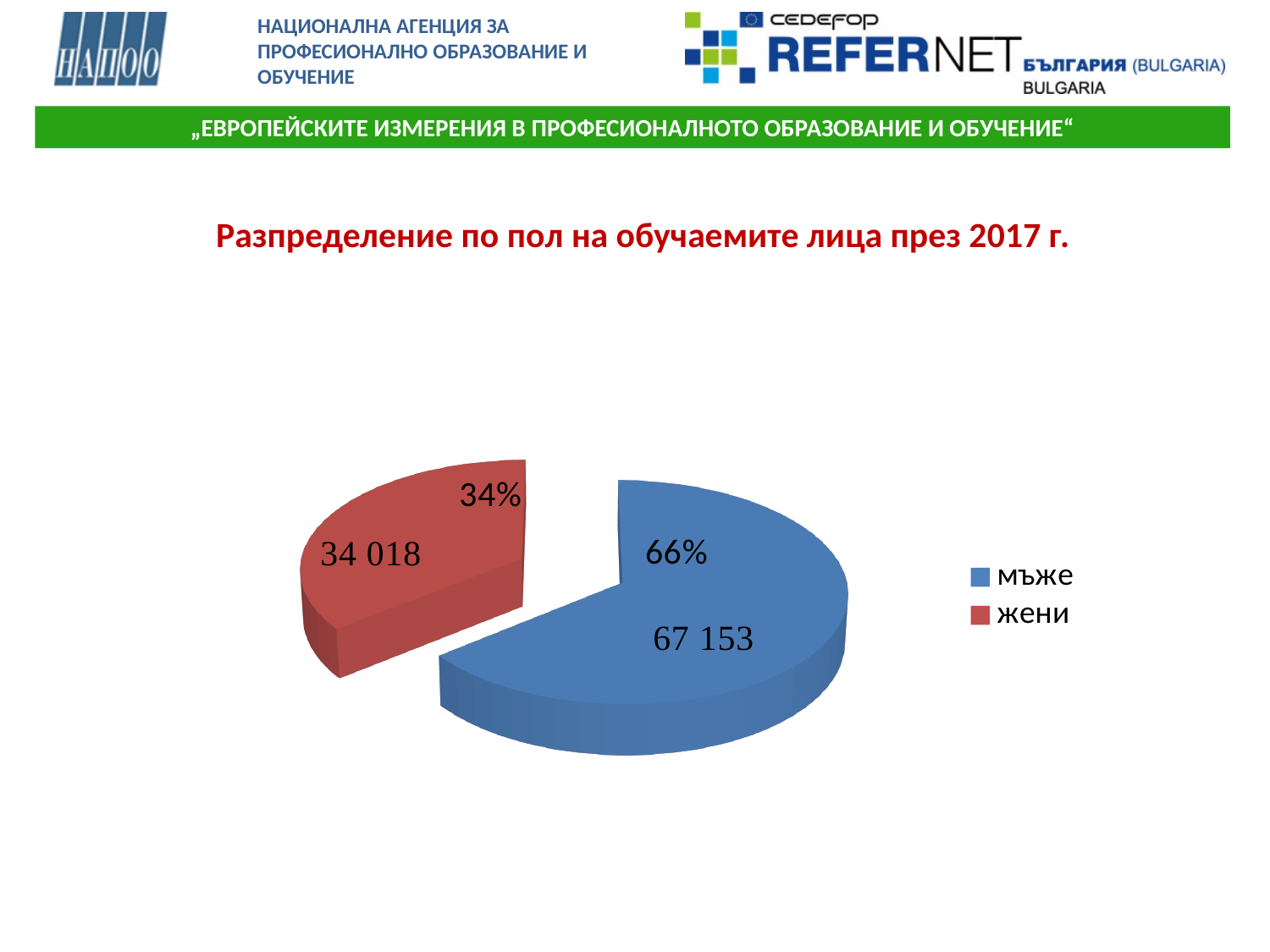
What share of the pie does мъже represent? 66% Which category has the smallest slice? жени Which category has the largest slice? мъже How many slices does the pie chart have? 2 What is the value for мъже? 67 153 What is the difference between the values for мъже and жени? 33 135 How many entries does the legend list? 2 What colour is the slice for жени? red What share of the pie does жени represent? 34% What is the value for жени? 34 018 What kind of chart is shown on the slide? pie chart Which is larger, the value for мъже or the value for жени? мъже